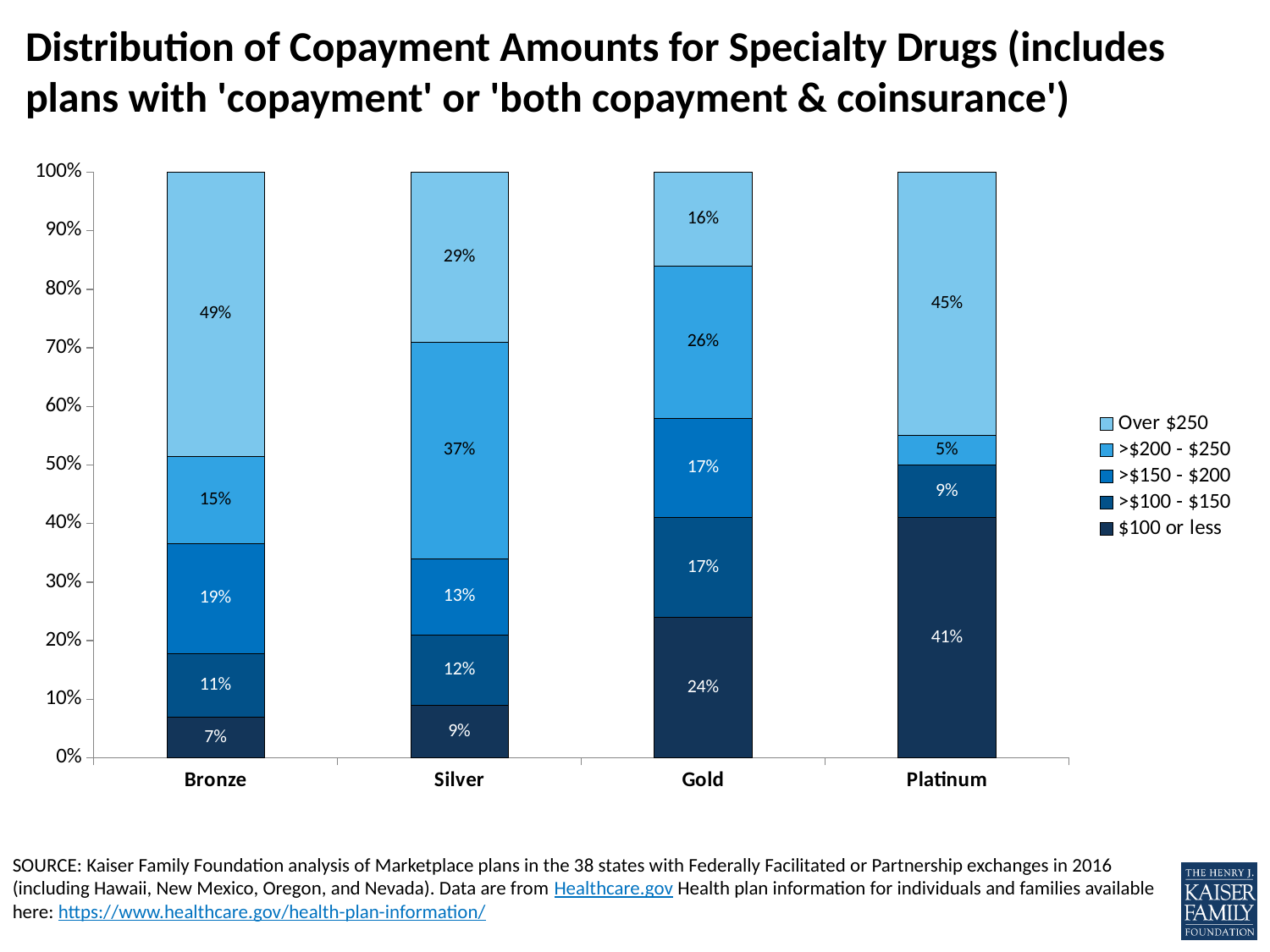
Which legend entry is shown in the darkest blue? $100 or less What is the value for the >$200 - $250 segment of the Platinum bar? 5% How many percentage points higher is the Over $250 share for Bronze than for Silver? 20 percentage points Which metal level has the largest share of plans with a copayment of $100 or less? Platinum What kind of chart is shown on the slide? Stacked bar chart What is the value for the >$150 - $200 segment of the Silver bar? 13% What percentage of Bronze plans have a specialty drug copayment of over $250? 49% Which metal level has the smallest share of plans with a copayment over $250? Gold How many metal levels are shown on the x axis? 4 Which has a larger >$200 - $250 share, Silver or Gold? Silver How many copayment ranges does the legend list? 5 What percentage of Gold plans have a specialty drug copayment of $100 or less? 24%